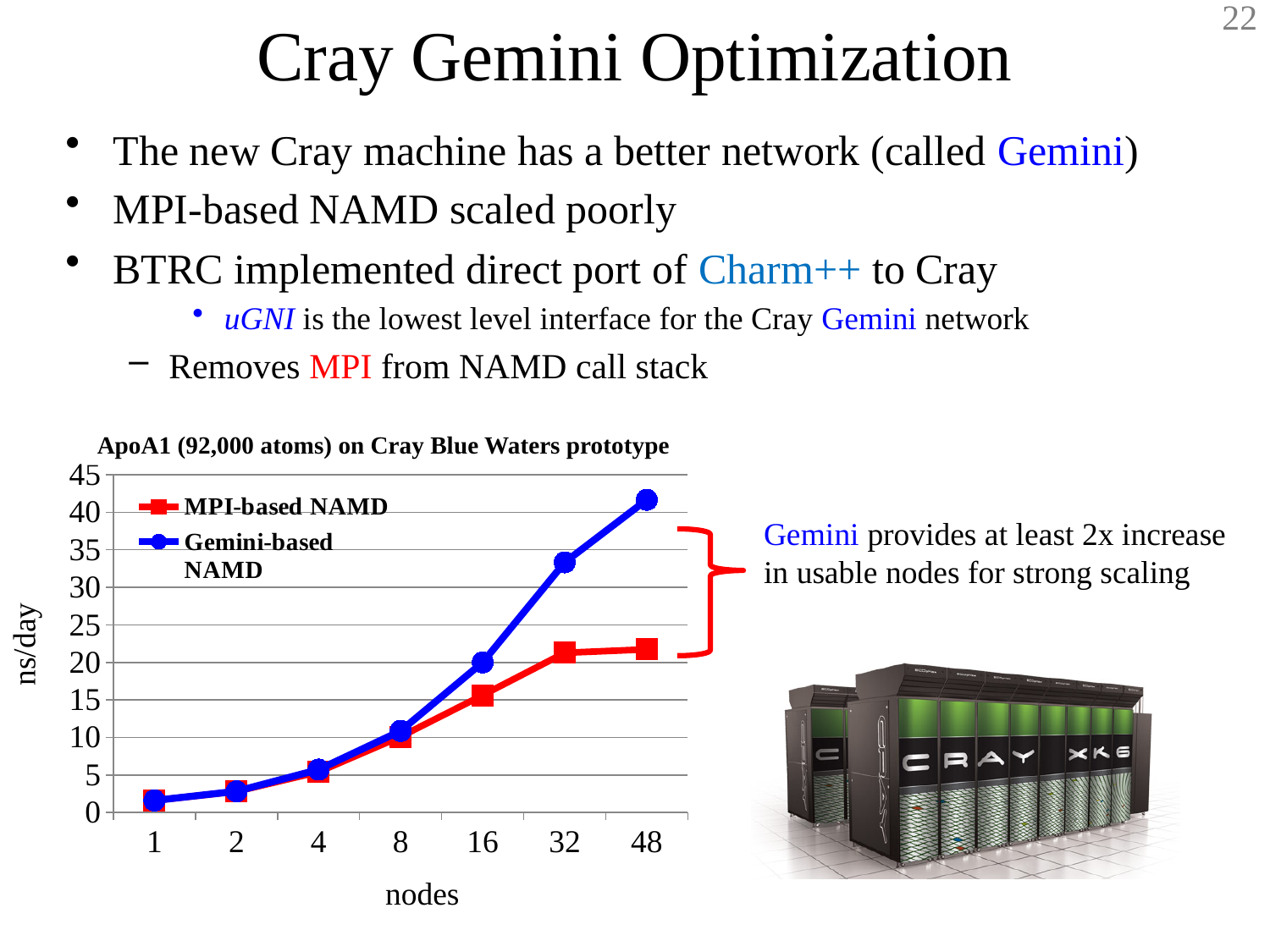
At which node count does Gemini-based NAMD reach its highest ns/day? 48 How many series does the chart legend list? 2 What kind of chart is shown on the slide? line chart Is the Gemini-based NAMD value at 48 nodes greater or less than 35? greater At which node count is the MPI-based NAMD value lowest? 1 Does the Gemini-based NAMD series rise or fall as the number of nodes increases? rise At 32 nodes, which series has the higher ns/day value? Gemini-based NAMD At 48 nodes, which series has the higher ns/day value, MPI-based NAMD or Gemini-based NAMD? Gemini-based NAMD What is the title of the chart? ApoA1 (92,000 atoms) on Cray Blue Waters prototype Is the MPI-based NAMD value at 48 nodes greater or less than 25? less What is the label of the y axis? ns/day How many node counts are plotted along the x axis? 7